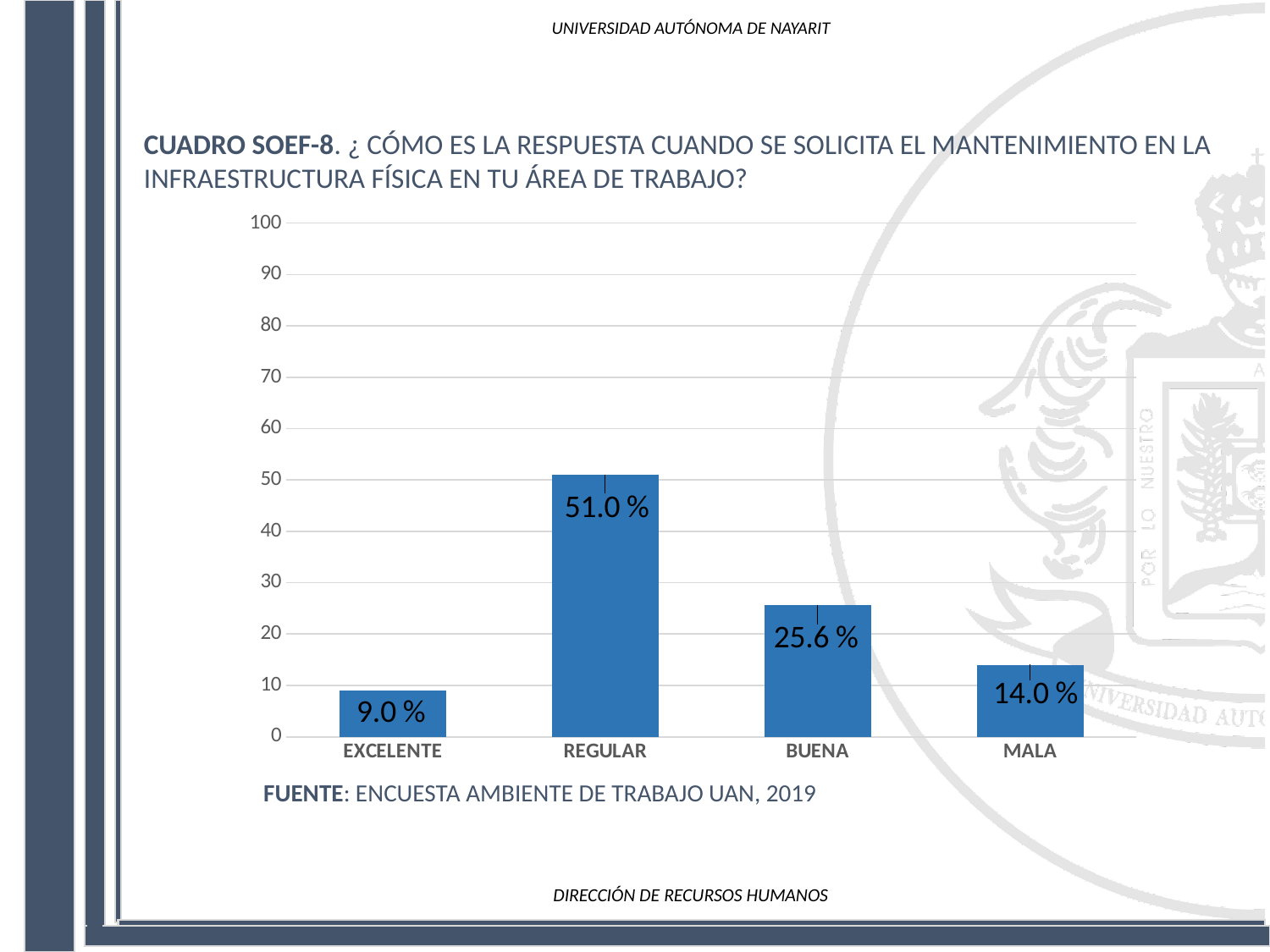
Which is larger, the value for BUENA or the value for MALA? BUENA Which category has the lowest value? EXCELENTE What source is cited below the chart? ENCUESTA AMBIENTE DE TRABAJO UAN, 2019 Which category has the highest value? REGULAR How many categories are shown on the x axis? 4 Is the value for REGULAR greater or less than 50? greater What is the value for REGULAR? 51.0 % What is the value for MALA? 14.0 % What is the difference between the values for REGULAR and BUENA? 25.4 % What is the value for EXCELENTE? 9.0 % What is the value for BUENA? 25.6 % What kind of chart is shown on the slide? bar chart